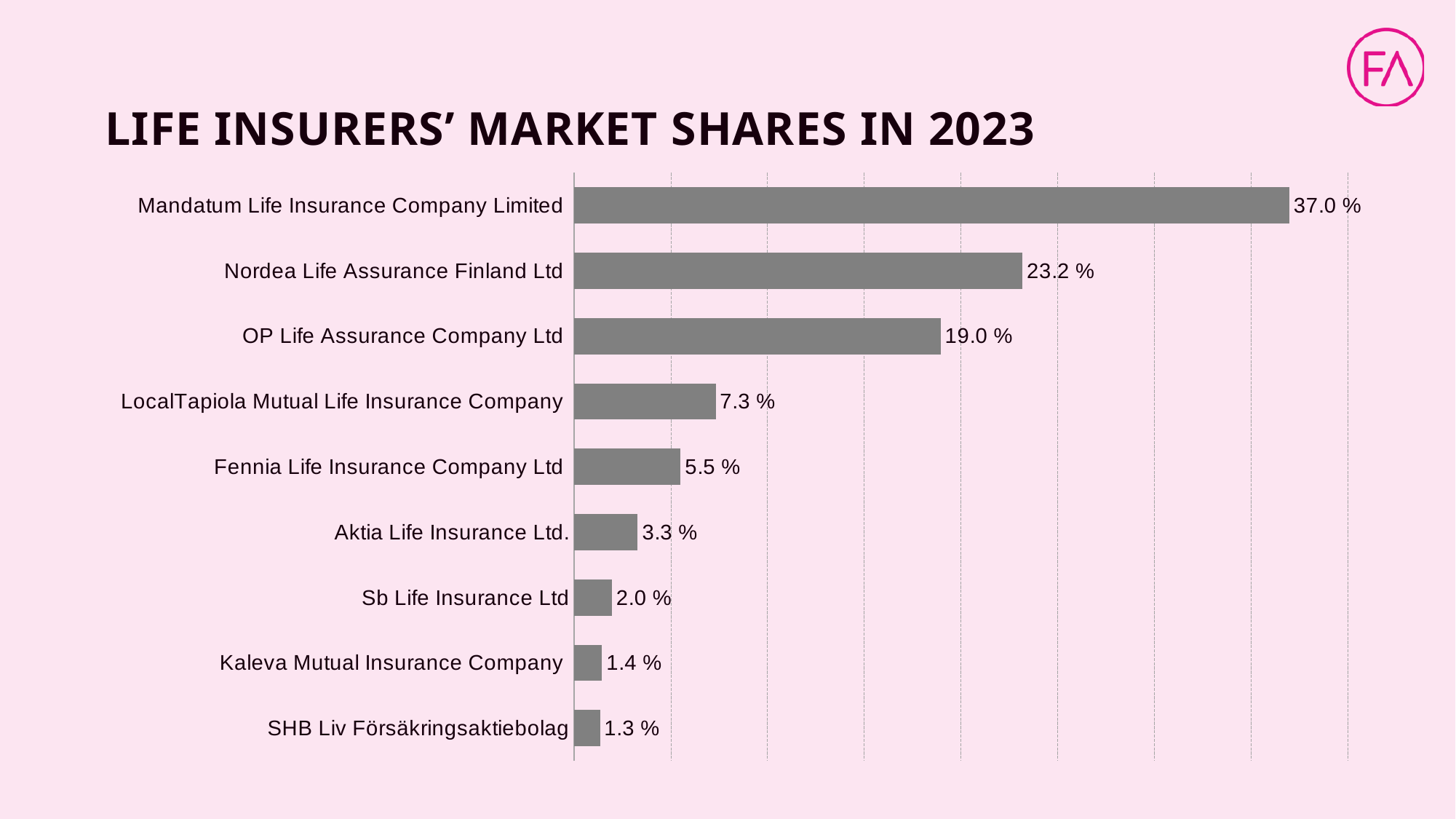
Which life insurer has the largest market share? Mandatum Life Insurance Company Limited What is the market share of Mandatum Life Insurance Company Limited? 37.0 % What is the title of the slide? LIFE INSURERS' MARKET SHARES IN 2023 What is the difference in market share between Mandatum Life Insurance Company Limited and Nordea Life Assurance Finland Ltd? 13.8 % What is the market share of Kaleva Mutual Insurance Company? 1.4 % How many life insurers are shown in the chart? 9 What is the market share of Fennia Life Insurance Company Ltd? 5.5 % Which life insurer has the smallest market share? SHB Liv Försäkringsaktiebolag What kind of chart is shown on the slide? Bar chart What is the difference in market share between LocalTapiola Mutual Life Insurance Company and Aktia Life Insurance Ltd.? 4.0 % What is the market share of OP Life Assurance Company Ltd? 19.0 % Which has a larger market share, Nordea Life Assurance Finland Ltd or OP Life Assurance Company Ltd? Nordea Life Assurance Finland Ltd